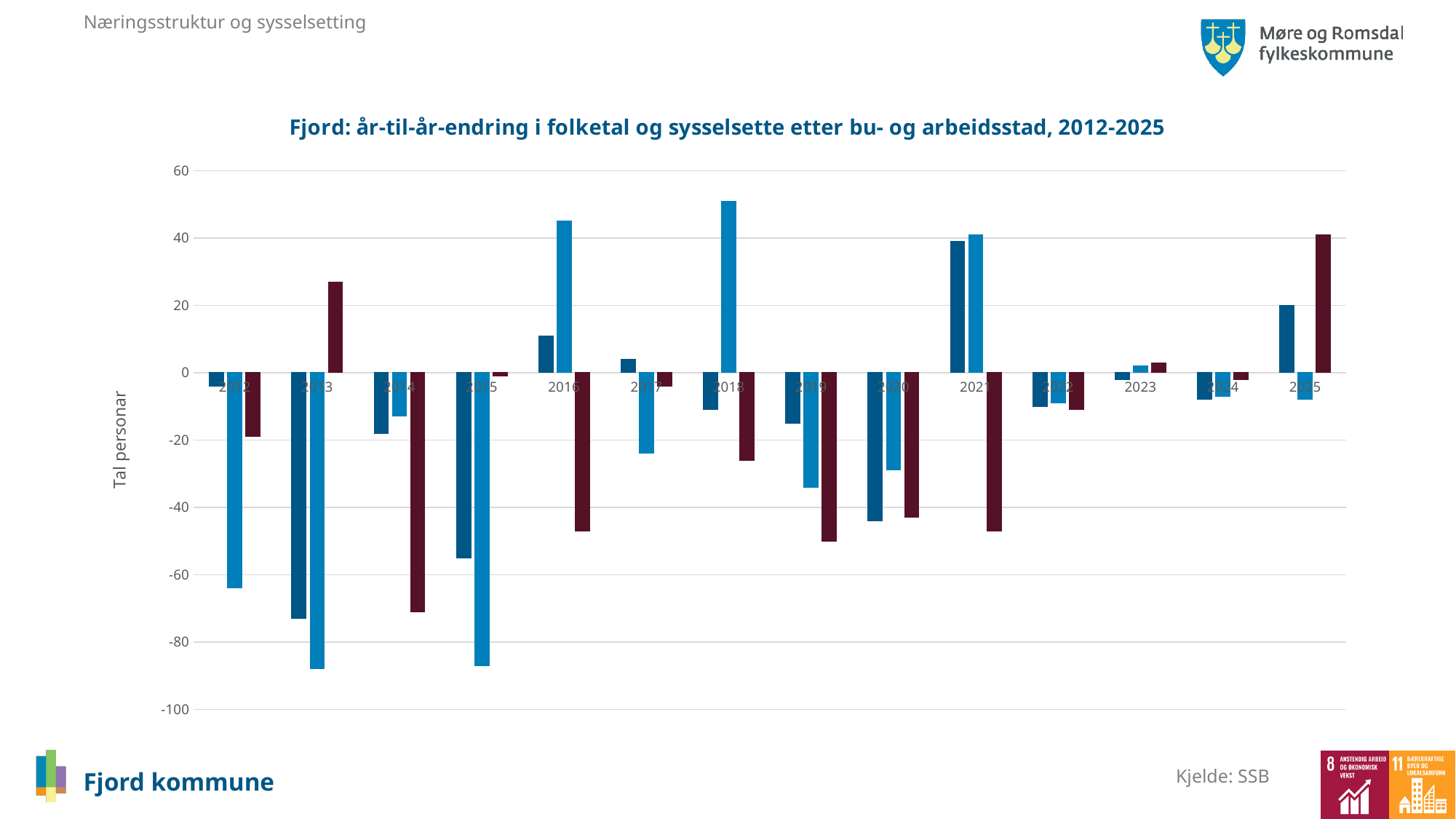
Is the value of the dark red bar for 2014 greater or less than -60? less How many bars are plotted for each year in the chart? 3 In which year does the light blue bar reach its highest value? 2018 What is the label on the vertical axis of the chart? Tal personar What is the title of the chart? Fjord: år-til-år-endring i folketal og sysselsette etter bu- og arbeidsstad, 2012-2025 Is the value of the dark blue bar for 2021 greater or less than 20? greater Is the value of the dark red bar for 2019 greater or less than -40? less How many years are shown on the x axis of the chart? 14 What kind of chart is shown on the slide? bar chart Which is larger, the light blue bar for 2016 or the light blue bar for 2018? 2018